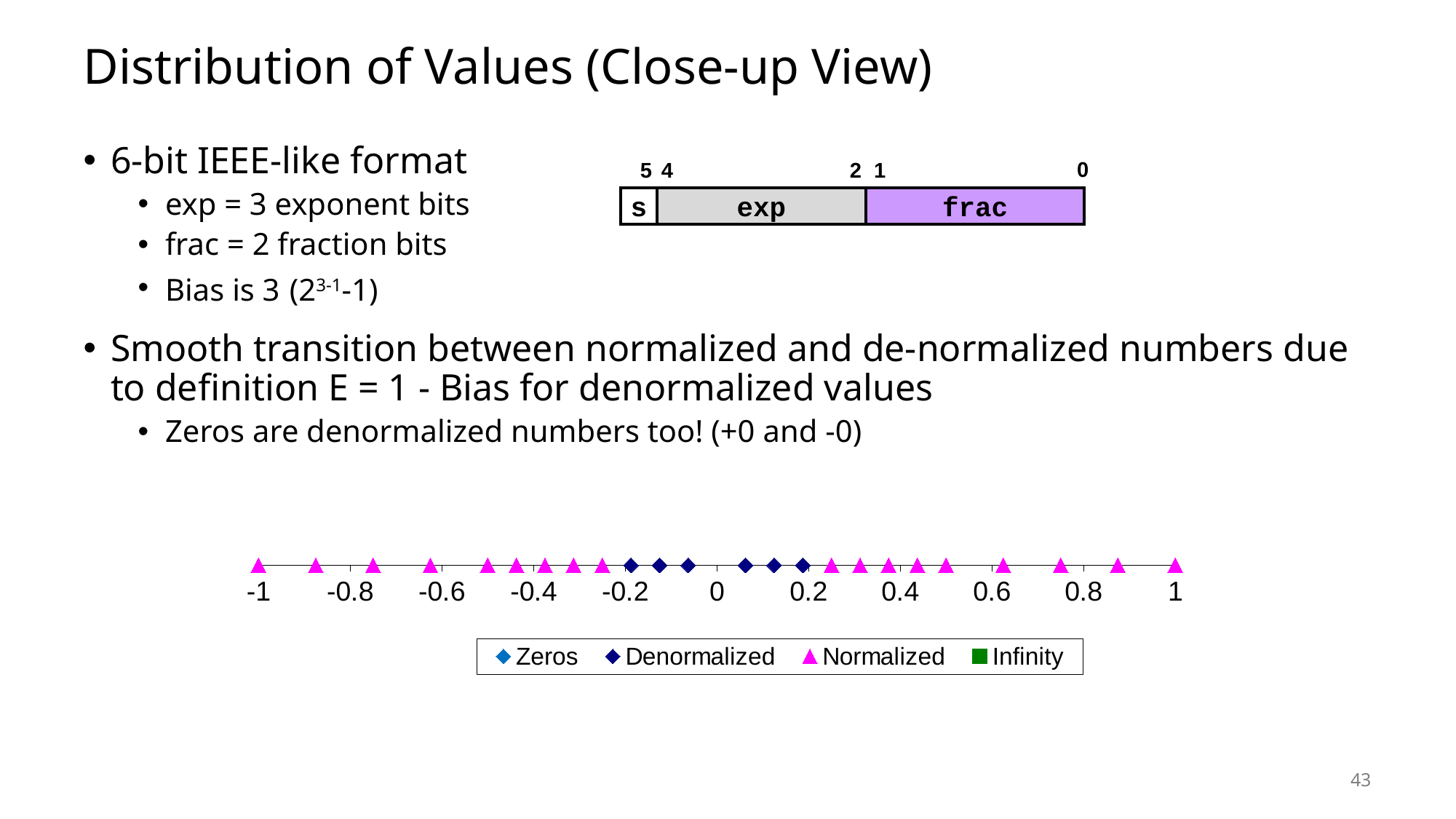
How many Normalized (triangle) points are plotted in the chart? 18 Which marker shape is used for the Normalized series in the chart? triangle What kind of chart is shown at the bottom of the slide? scatter chart What is the smallest value at which a Normalized point is plotted in the chart? -1 How many Denormalized (diamond) points are plotted in the chart, excluding zero? 6 How many series does the legend of the chart list? 4 What is the rightmost value labelled on the chart's x axis? 1 Is the smallest positive Normalized point in the chart plotted at a value greater or less than 0.2? greater What is the largest value at which a Normalized point is plotted in the chart? 1 What is the leftmost value labelled on the chart's x axis? -1 What are the four series named in the chart legend? Zeros, Denormalized, Normalized, Infinity